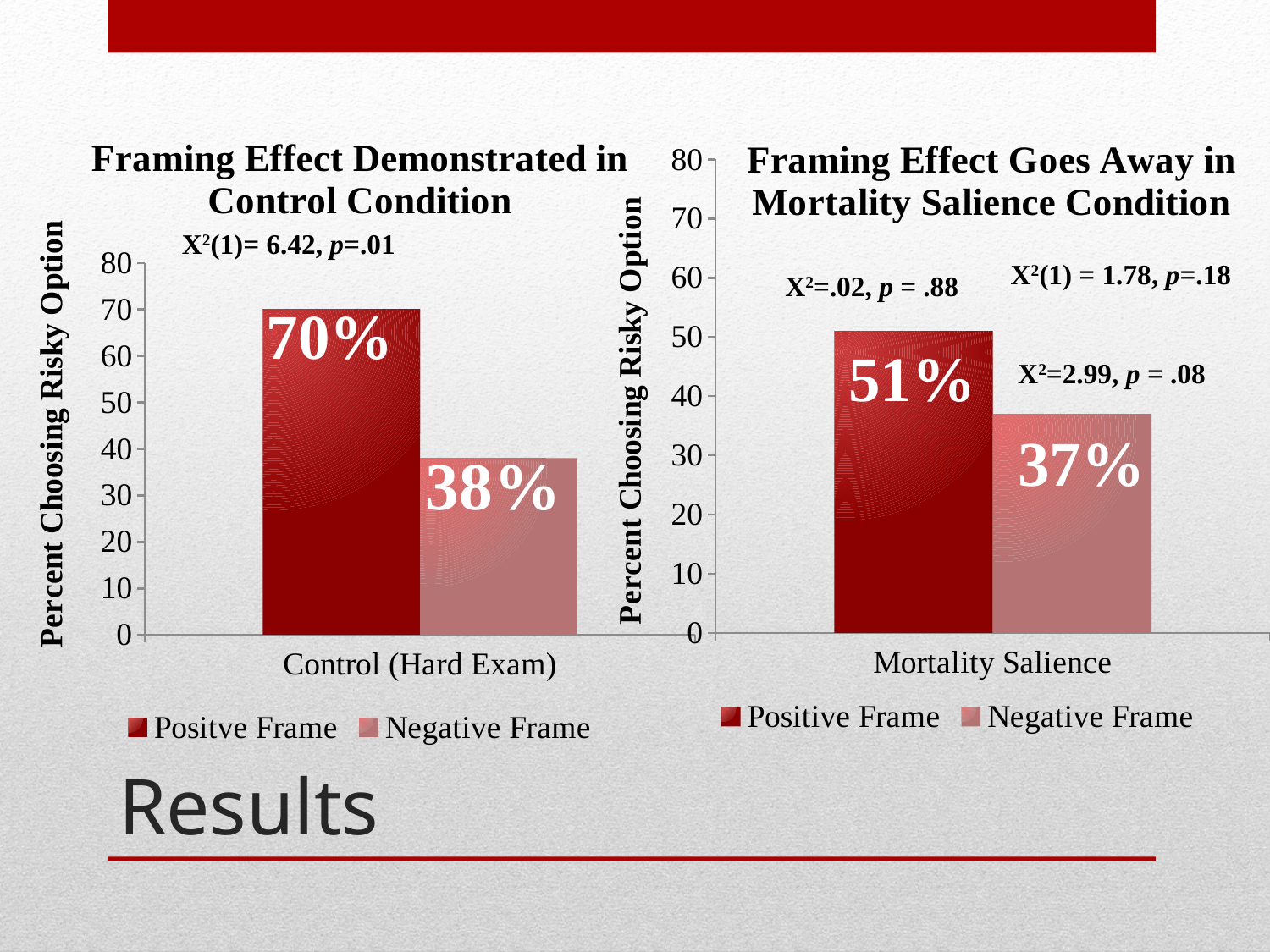
In the left chart (Framing Effect Demonstrated in Control Condition), what percent chose the risky option in the Negative Frame? 38% Is the Positive Frame value in the left chart larger or smaller than the Positive Frame value in the right chart? larger In the right chart (Framing Effect Goes Away in Mortality Salience Condition), which frame has the lower percent choosing the risky option? Negative Frame In the left chart (Framing Effect Demonstrated in Control Condition), what is the difference between the Positive Frame and Negative Frame values? 32% In the left chart (Framing Effect Demonstrated in Control Condition), what percent chose the risky option in the Positive Frame? 70% In the right chart (Framing Effect Goes Away in Mortality Salience Condition), what percent chose the risky option in the Positive Frame? 51% In the right chart (Framing Effect Goes Away in Mortality Salience Condition), what percent chose the risky option in the Negative Frame? 37% What is the y-axis label of the right chart (Framing Effect Goes Away in Mortality Salience Condition)? Percent Choosing Risky Option What type of chart is the left chart (Framing Effect Demonstrated in Control Condition)? bar chart In the left chart (Framing Effect Demonstrated in Control Condition), which frame has the higher percent choosing the risky option? Positive Frame In the right chart (Framing Effect Goes Away in Mortality Salience Condition), what is the difference between the Positive Frame and Negative Frame values? 14% How many series does the legend of the right chart (Framing Effect Goes Away in Mortality Salience Condition) list? 2